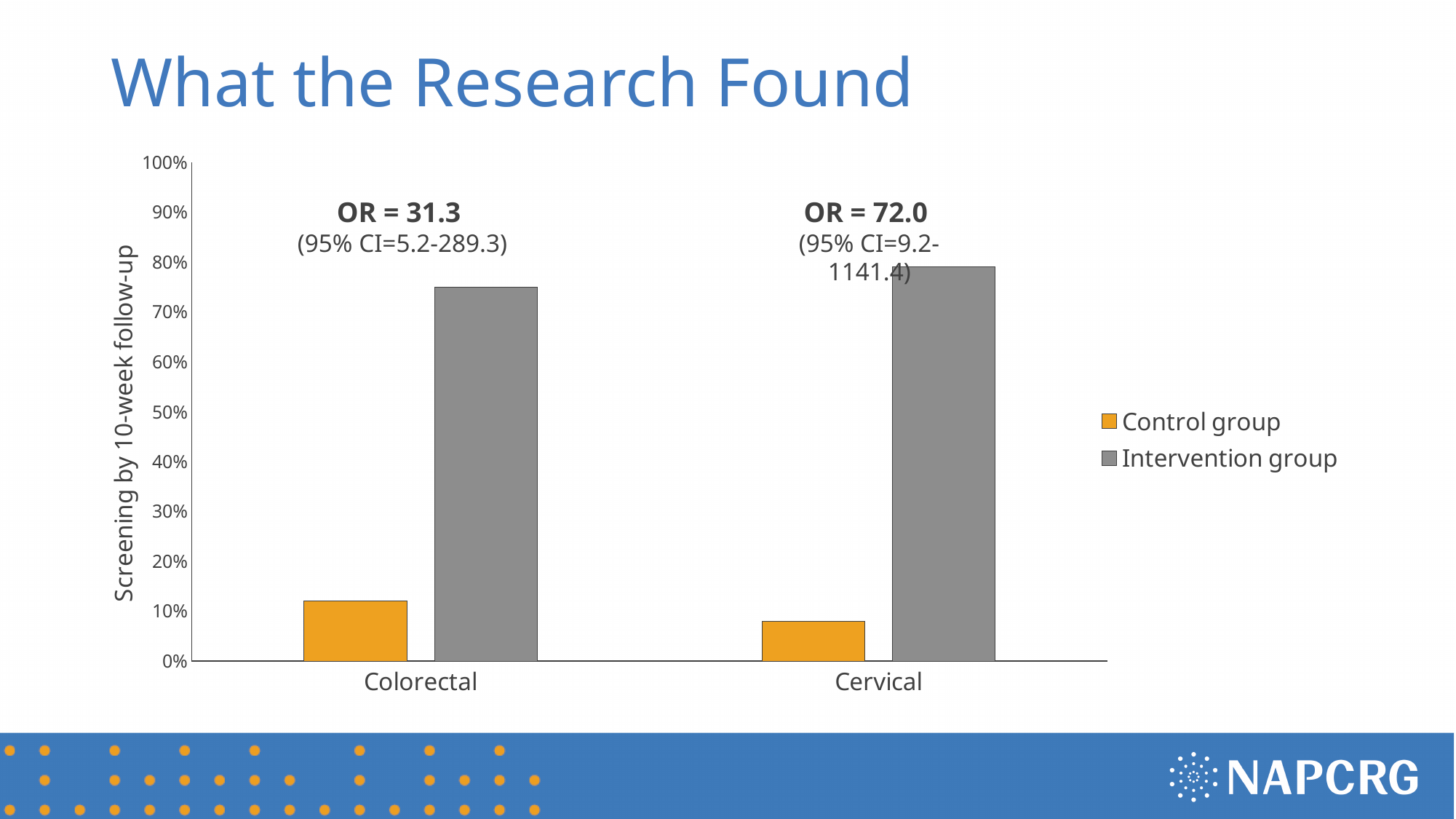
What is the odds ratio (OR) printed above the Colorectal bars? OR = 31.3 For Cervical screening, which group has the higher value, Control group or Intervention group? Intervention group How many categories are shown on the x axis? 2 What is the label on the vertical axis? Screening by 10-week follow-up Is the Control group value for Cervical greater or less than 10%? less Which category has the higher Control group value, Colorectal or Cervical? Colorectal Is the Intervention group value for Colorectal greater or less than 70%? greater How many series does the legend list? 2 What is the odds ratio (OR) printed above the Cervical bars? OR = 72.0 Is the Control group value for Colorectal greater or less than 20%? less What 95% confidence interval is printed for the Colorectal odds ratio? 5.2-289.3 What kind of chart is shown on the slide? bar chart